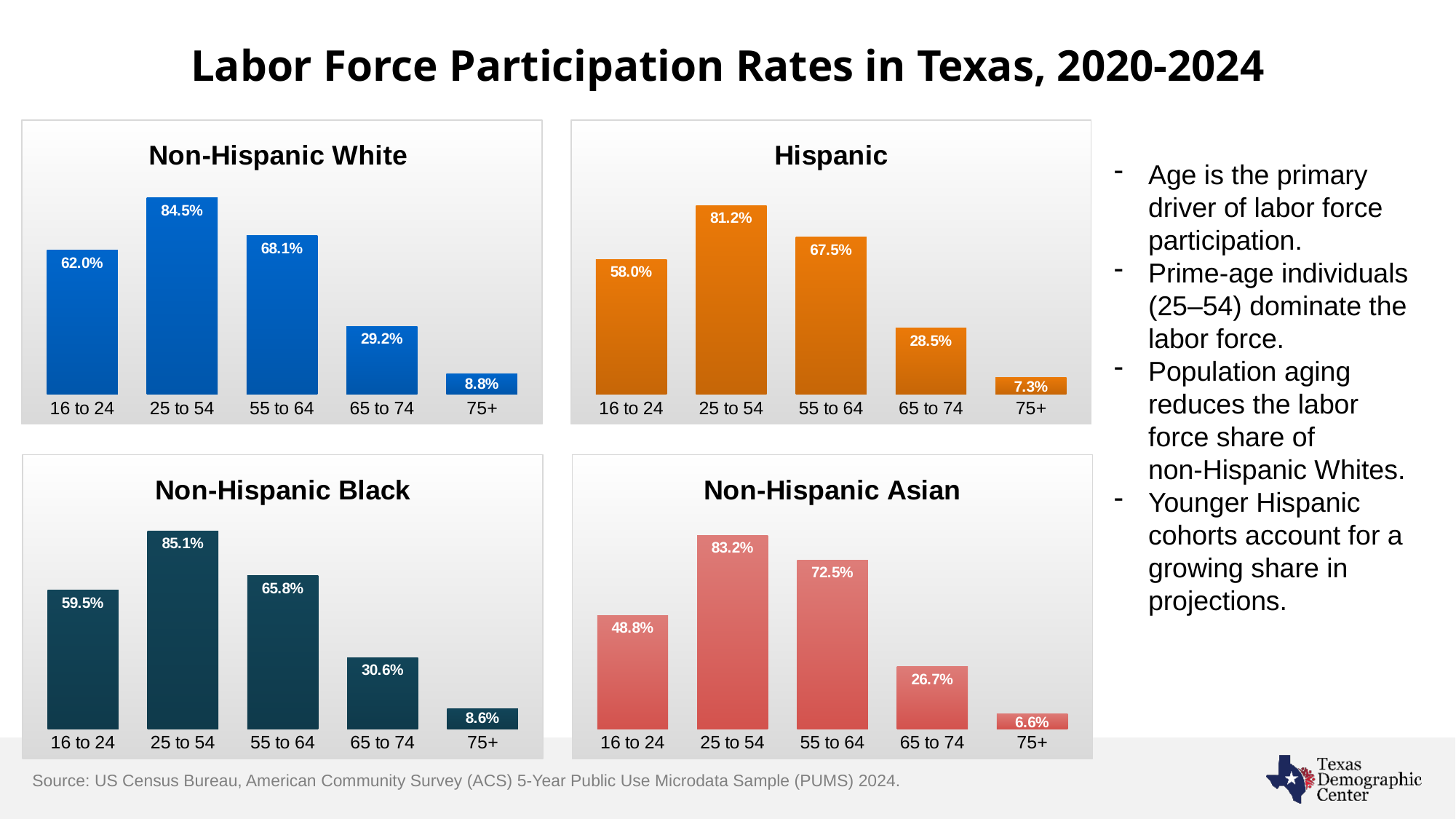
In the Non-Hispanic Black chart, which is larger: the value for 16 to 24 or the value for 55 to 64? 55 to 64 In the Non-Hispanic Asian chart, which age group has the lowest participation rate? 75+ How many age groups are shown in the Hispanic chart? 5 In the Hispanic chart, what is the value for the 75+ age group? 7.3% In the Non-Hispanic White chart, what is the labor force participation rate for the 25 to 54 age group? 84.5% In the Non-Hispanic Asian chart, what is the value for the 16 to 24 age group? 48.8% In the Non-Hispanic White chart, do the values rise or fall from the 55 to 64 group to the 75+ group? Fall In the Hispanic chart, what is the difference between the 16 to 24 and 65 to 74 values? 29.5% In the Non-Hispanic White chart, what is the difference between the 25 to 54 and 55 to 64 values? 16.4% What kind of chart is the Non-Hispanic Asian chart? Bar chart In the Non-Hispanic Black chart, which age group has the highest participation rate? 25 to 54 How many charts are shown on the slide? 4